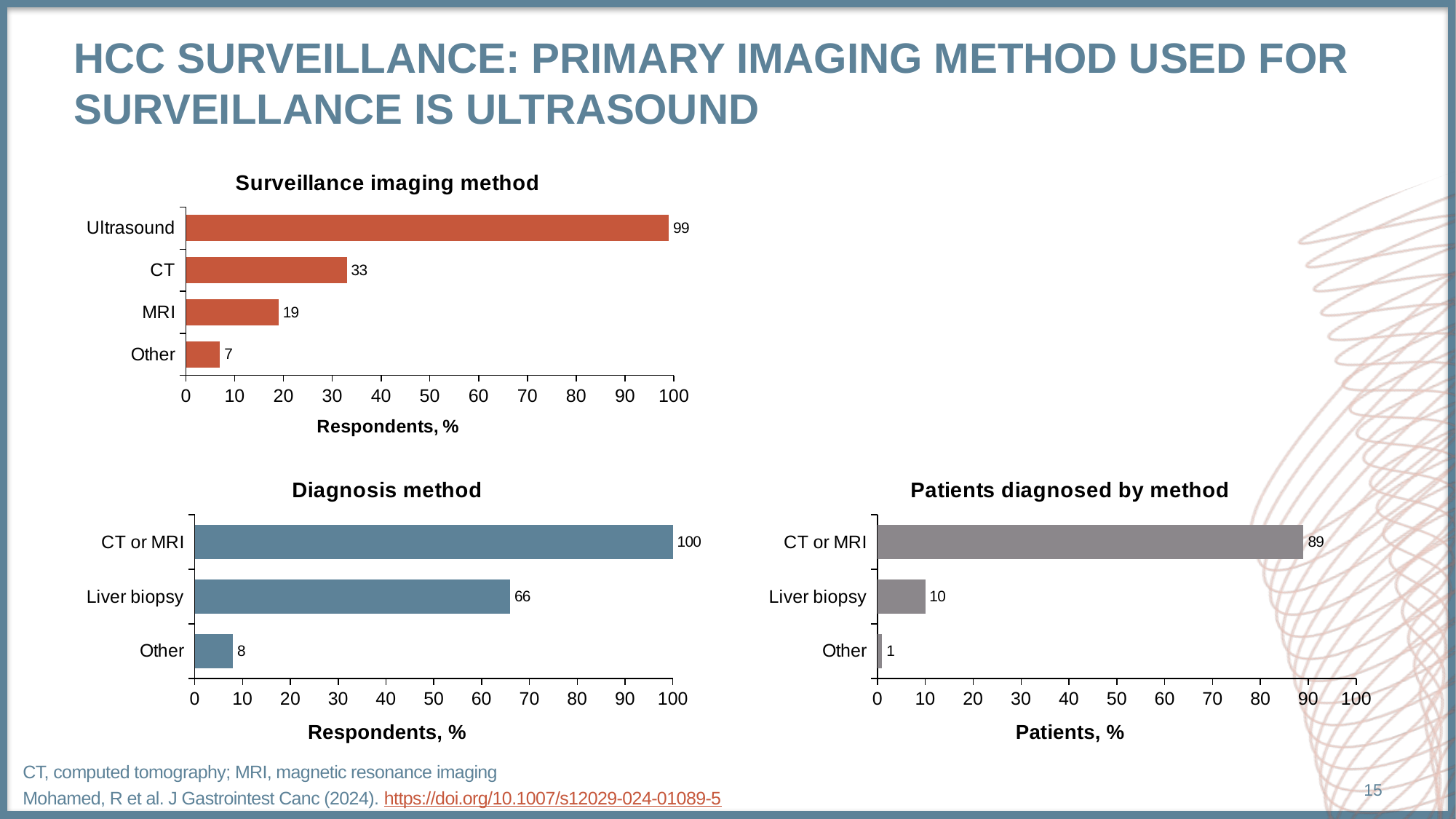
In the 'Patients diagnosed by method' chart, what is the difference between the values for CT or MRI and Liver biopsy? 79 What kind of chart is the 'Patients diagnosed by method' chart? Bar chart In the 'Diagnosis method' chart, is the value for Liver biopsy greater or less than 60? greater In the 'Patients diagnosed by method' chart, what is the value for CT or MRI? 89 In the 'Surveillance imaging method' chart, how many categories are shown? 4 Which is larger: the value for Liver biopsy in the 'Diagnosis method' chart or the value for Liver biopsy in the 'Patients diagnosed by method' chart? Diagnosis method What is the x-axis label of the 'Patients diagnosed by method' chart? Patients, % In the 'Diagnosis method' chart, which category has the highest value? CT or MRI In the 'Diagnosis method' chart, what is the value for Liver biopsy? 66 In the 'Surveillance imaging method' chart, what is the value for Ultrasound? 99 In the 'Surveillance imaging method' chart, what is the difference between the values for CT and MRI? 14 In the 'Surveillance imaging method' chart, which category has the lowest value? Other